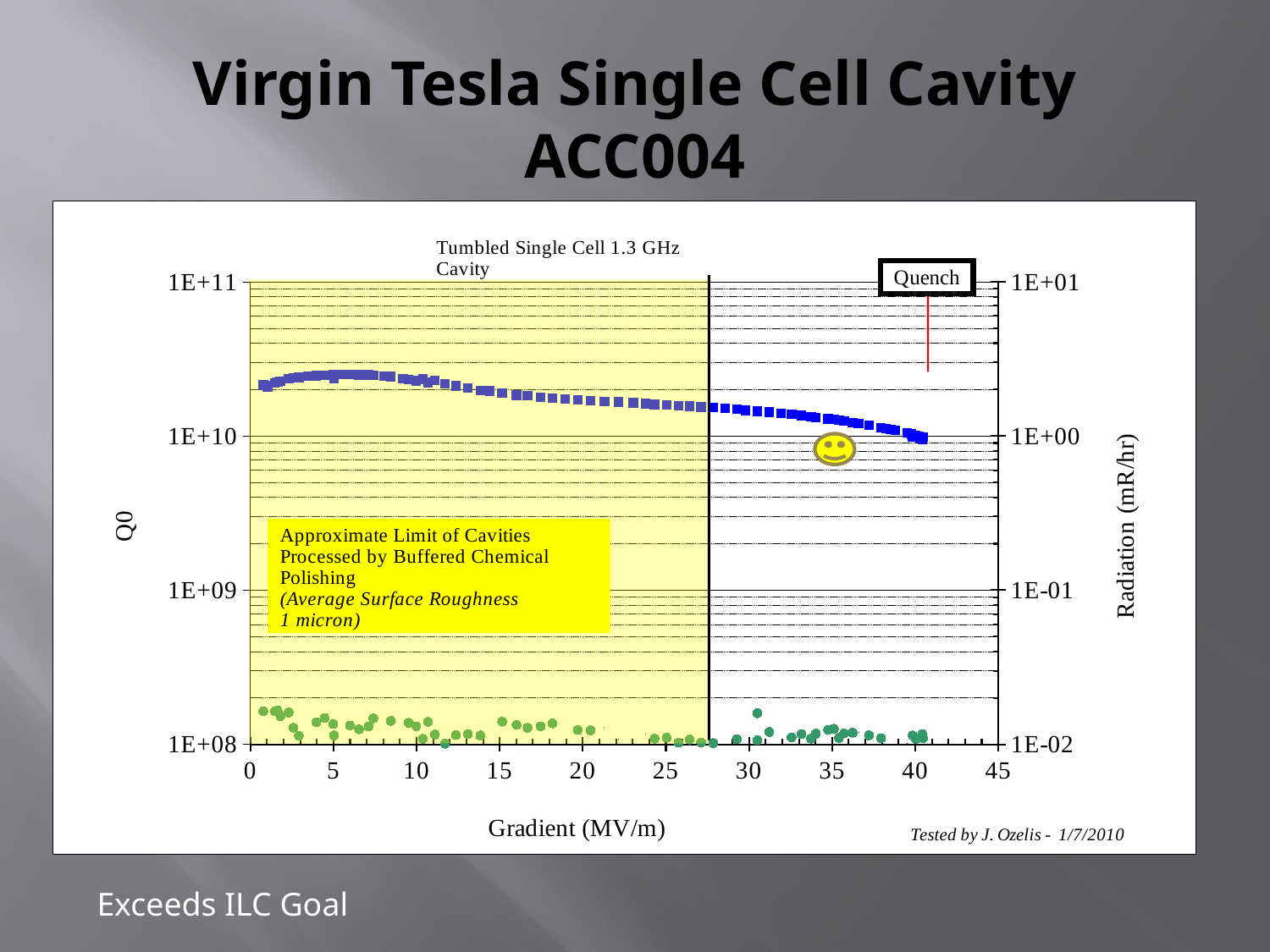
Is the radiation value at a gradient of 35 MV/m greater or less than 1E+00 mR/hr? less Is the Q0 value at a gradient of 30 MV/m greater or less than 1E+09? greater Is the Q0 value at a gradient of 20 MV/m greater or less than 1E+11? less What is the title of the chart? Tumbled Single Cell 1.3 GHz Cavity What label is shown in the box above the red vertical line near the end of the Q0 data? Quench Does Q0 rise or fall as the gradient increases from 10 MV/m to 40 MV/m? falls Which has the larger Q0 value: the point at a gradient of 5 MV/m or the point at a gradient of 40 MV/m? 5 MV/m What kind of chart is shown on the slide? scatter chart